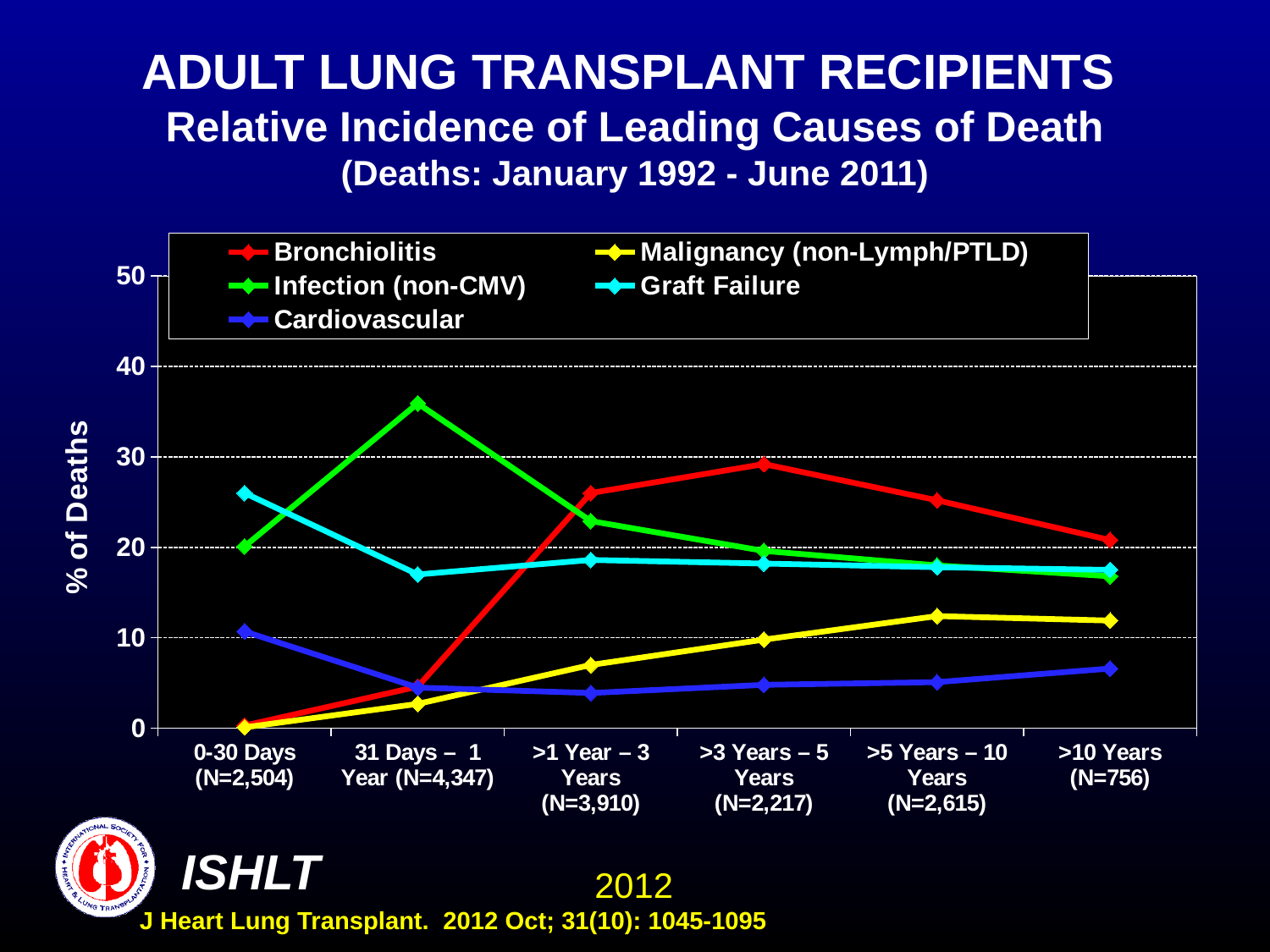
How many time-period categories are shown on the x axis? 6 Is the value for Infection (non-CMV) in the 31 Days – 1 Year period greater or less than 30? greater What kind of chart is shown on the slide? line chart Which cause of death has the lowest % of deaths in the >10 Years period? Cardiovascular Is the value for Bronchiolitis in the 0-30 Days period greater or less than 10? less What is the label on the y axis? % of Deaths Does the Bronchiolitis line rise or fall from >3 Years – 5 Years to >10 Years? fall Which cause of death has the highest % of deaths in the >3 Years – 5 Years period? Bronchiolitis How many series does the legend list? 5 Does the Malignancy (non-Lymph/PTLD) line rise or fall from 0-30 Days to >5 Years – 10 Years? rise In the 0-30 Days period, which is larger: Graft Failure or Cardiovascular? Graft Failure Which cause of death has the highest % of deaths in the 31 Days – 1 Year period? Infection (non-CMV)